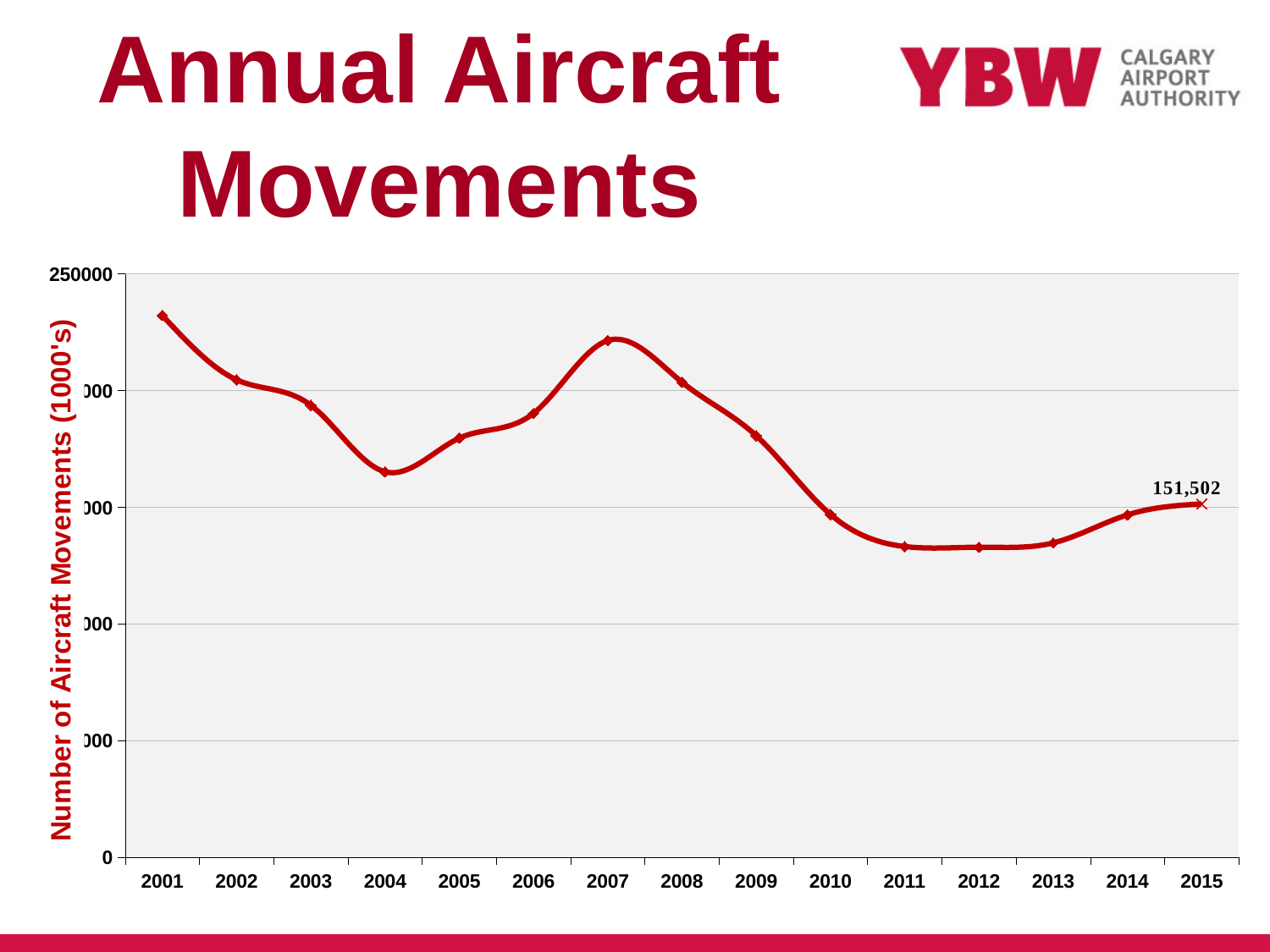
Which year has the highest number of aircraft movements? 2001 What is the value labelled for 2015? 151,502 Is the value for 2001 greater or less than 200000? greater How many years are plotted on the x axis? 15 Which year has the larger value, 2004 or 2010? 2004 Do the values rise or fall from 2001 to 2004? fall Is the value for 2011 greater or less than 150000? less What kind of chart is shown on the slide? line chart Is the value for 2004 greater or less than 200000? less Do the values rise or fall from 2012 to 2015? rise Which year has the larger value, 2001 or 2007? 2001